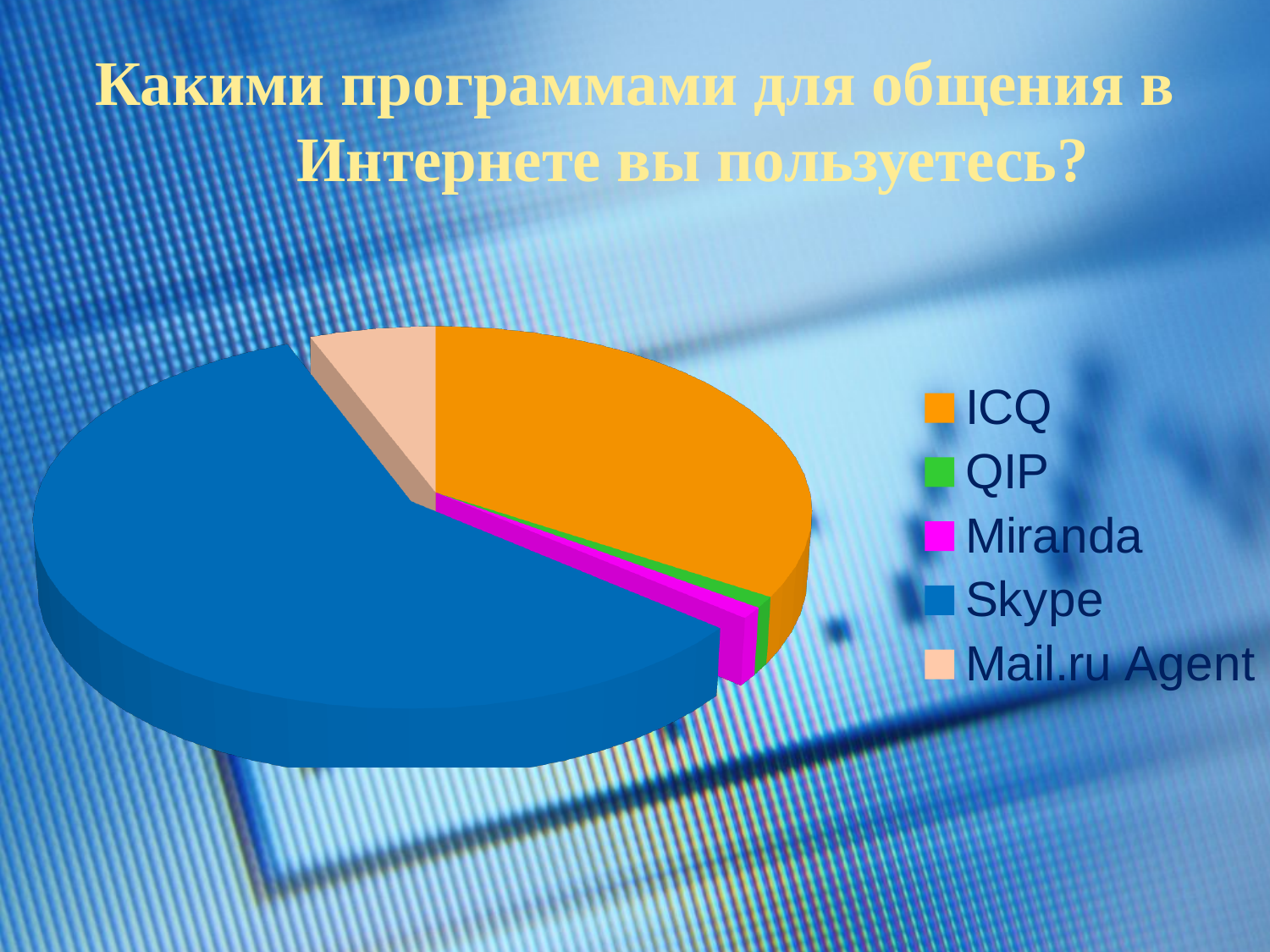
What kind of chart is shown on the slide? Pie chart How many categories does the pie chart have? 5 Which slice is larger, Mail.ru Agent or Miranda? Mail.ru Agent What colour is the Skype slice in the pie chart? Blue Which program has the largest slice of the pie? Skype Which slice is larger, Skype or ICQ? Skype Which slice is larger, ICQ or Mail.ru Agent? ICQ What is the title of the slide? Какими программами для общения в Интернете вы пользуетесь? How many entries does the legend list? 5